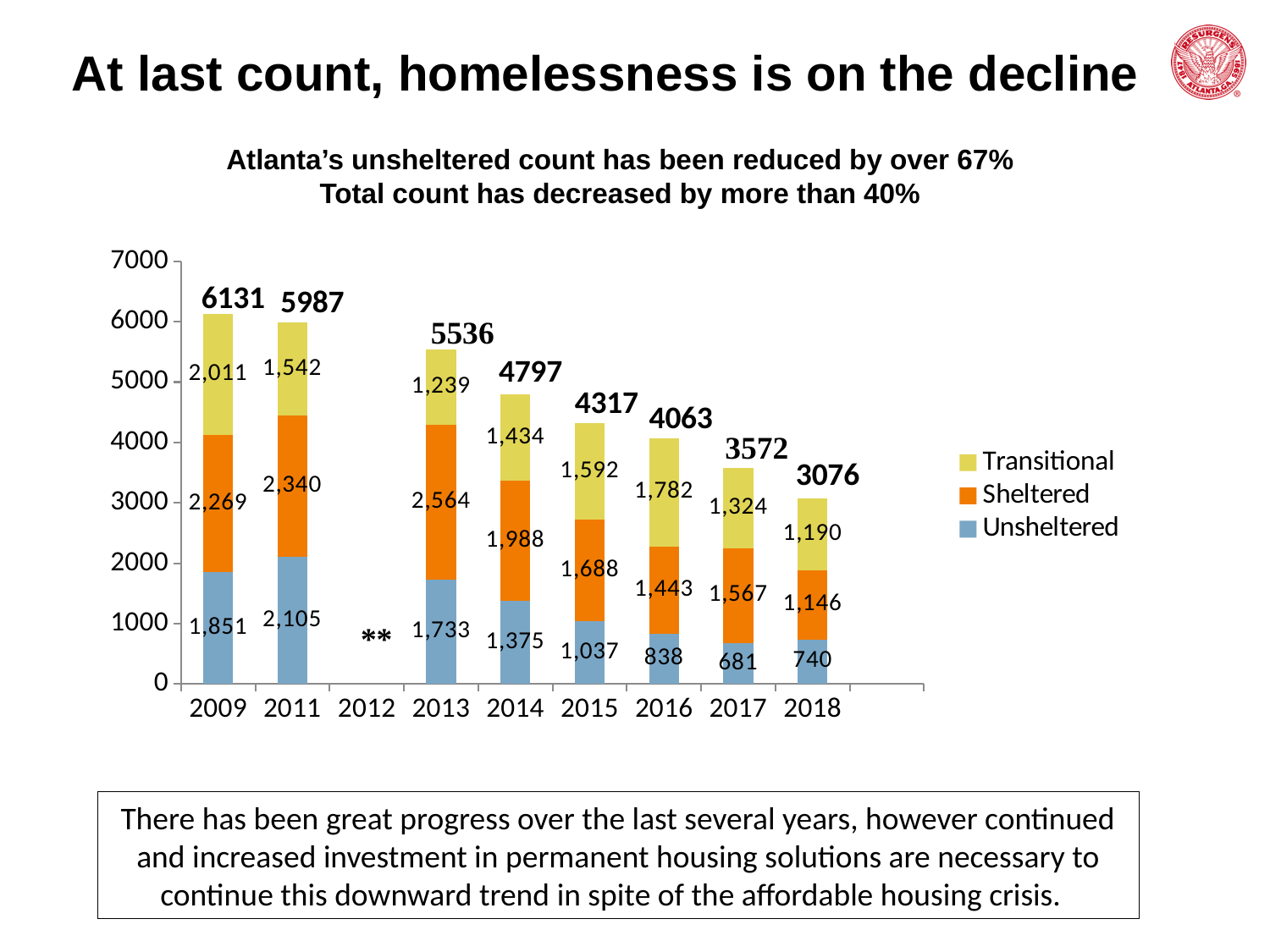
How many series does the legend list? 3 What kind of chart is shown on the slide? Stacked bar chart What is the total count shown above the 2018 bar? 3076 Which year has the lowest Unsheltered value? 2017 What is the difference between the total count in 2009 and the total count in 2018? 3055 What is the Transitional value for 2015? 1,592 Do the total counts rise or fall from 2009 to 2018? Fall What is the Unsheltered value for 2009? 1,851 Which year on the x axis has no bar and is marked with '**'? 2012 Which year has the highest total count? 2009 In 2011, which is larger: the Sheltered value or the Transitional value? Sheltered What is the Sheltered value for 2013? 2,564